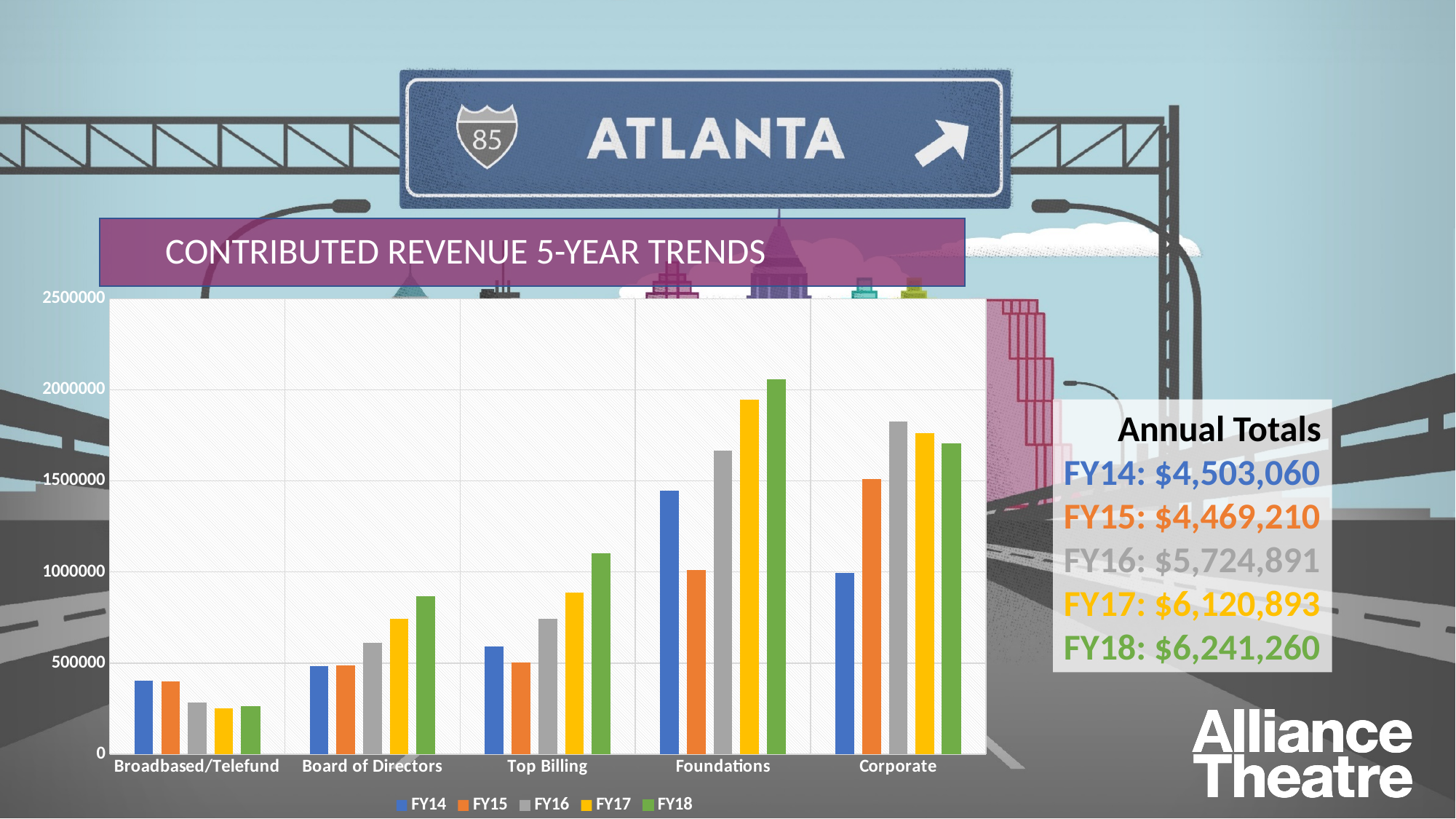
Which category has the lowest bars overall in the chart? Broadbased/Telefund Which series has the highest value for Foundations? FY18 How many series does the chart legend list? 5 What kind of chart is shown on the slide? bar chart Is the FY16 value for Corporate greater or less than 1500000? greater Is the FY14 value for Broadbased/Telefund greater or less than 500000? less For Corporate, which is larger: the FY16 value or the FY18 value? FY16 Which category has the tallest bar in the chart? Foundations How many categories are shown on the x axis of the chart? 5 What is the title of the chart? CONTRIBUTED REVENUE 5-YEAR TRENDS Is the FY18 value for Board of Directors greater or less than 1000000? less Do the values for Board of Directors rise or fall from FY14 to FY18? rise